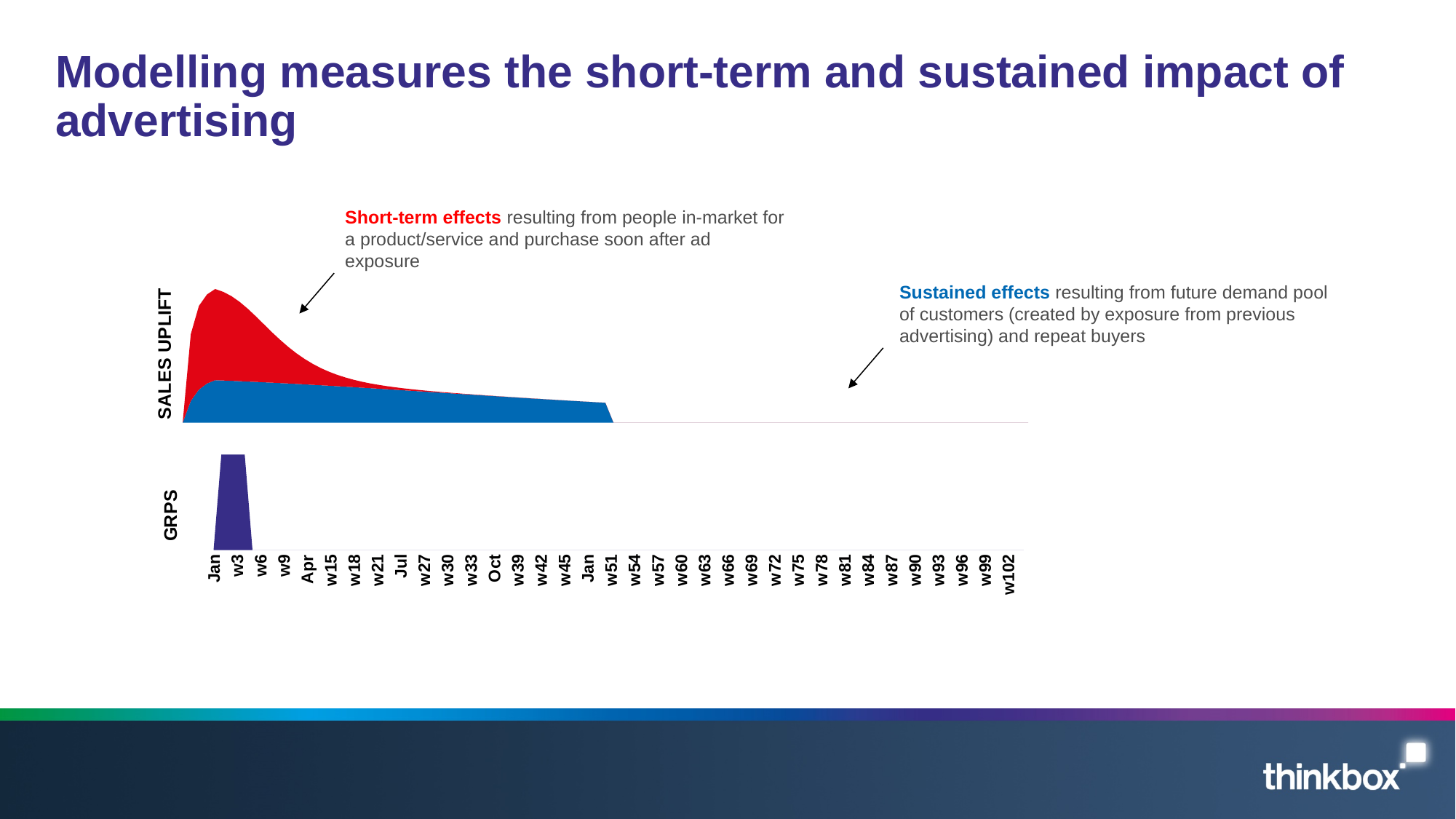
What is the last label on the x axis of the charts? w102 In the SALES UPLIFT chart, does the red short-term effects area rise or fall after its peak near the start of the x axis? fall What is the y-axis label of the lower chart? GRPS In the SALES UPLIFT chart, which peaks higher: the red short-term effects area or the blue sustained effects area? red short-term effects How many labels are shown on the x axis of the charts? 35 What kind of chart is the SALES UPLIFT chart on the slide? area chart Which colour represents short-term effects in the SALES UPLIFT chart? red What is the first label on the x axis of the charts? Jan In the GRPS chart, near which x-axis labels does the single spike of GRPs occur? Jan and w3 In the SALES UPLIFT chart, which effect lasts longer along the x axis: short-term effects or sustained effects? sustained effects